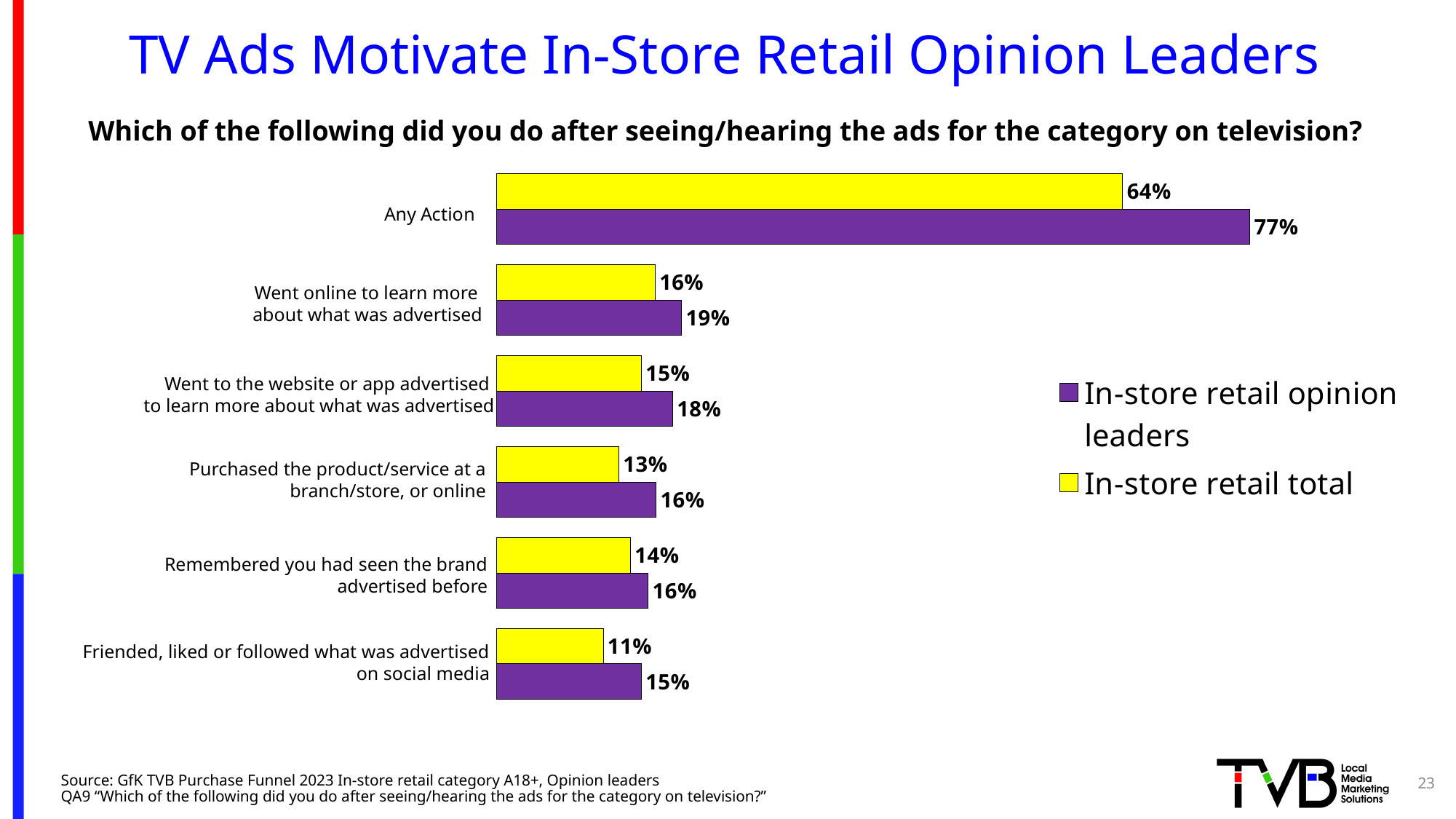
What is the value for In-store retail opinion leaders for Any Action? 77% What is the value for In-store retail opinion leaders for 'Went online to learn more about what was advertised'? 19% Which category has the lowest value for In-store retail total? Friended, liked or followed what was advertised on social media How many categories are shown on the chart? 6 What is the value for In-store retail total for Any Action? 64% What kind of chart is shown on the slide? Bar chart What is the difference between In-store retail opinion leaders and In-store retail total for Any Action? 13% What is the value for In-store retail total for 'Friended, liked or followed what was advertised on social media'? 11% Which category has the highest value for In-store retail opinion leaders? Any Action What is the value for In-store retail opinion leaders for 'Purchased the product/service at a branch/store, or online'? 16% For 'Went to the website or app advertised to learn more about what was advertised', which series has the larger value? In-store retail opinion leaders How many series does the legend list? 2